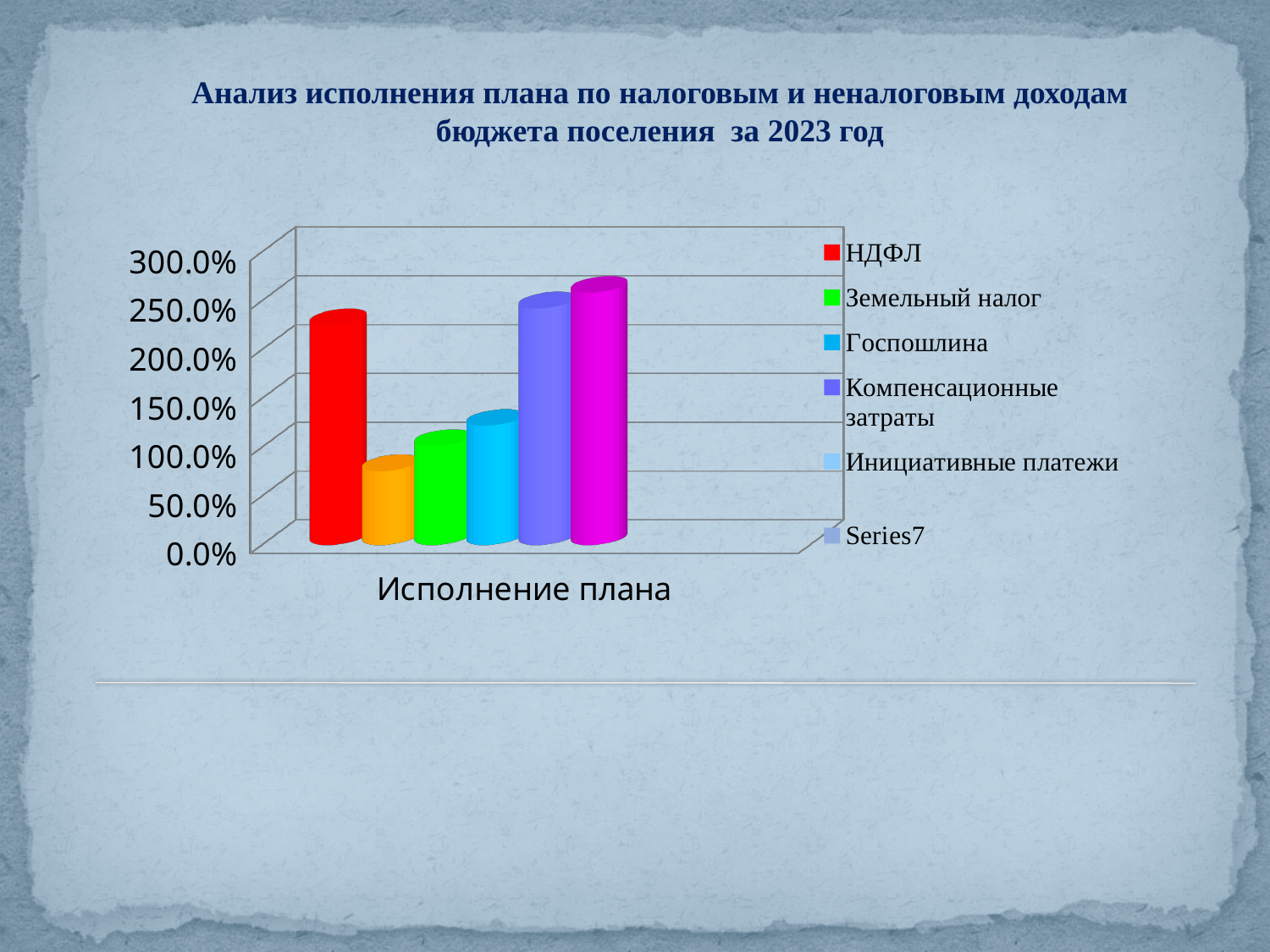
Which is larger, the value for НДФЛ or the value for Земельный налог? НДФЛ What kind of chart is shown on the slide? bar chart Which is larger, the value for Госпошлина or the value for Земельный налог? Госпошлина How many entries does the chart legend list? 6 Is the value for Госпошлина greater or less than 100.0%? greater Is the value for Земельный налог greater or less than 150.0%? less Is the value for НДФЛ greater or less than 200.0%? greater How many bars are plotted in the chart? 6 What is the category label shown under the bars on the x axis? Исполнение плана What is the highest value shown on the vertical axis of the chart? 300.0%